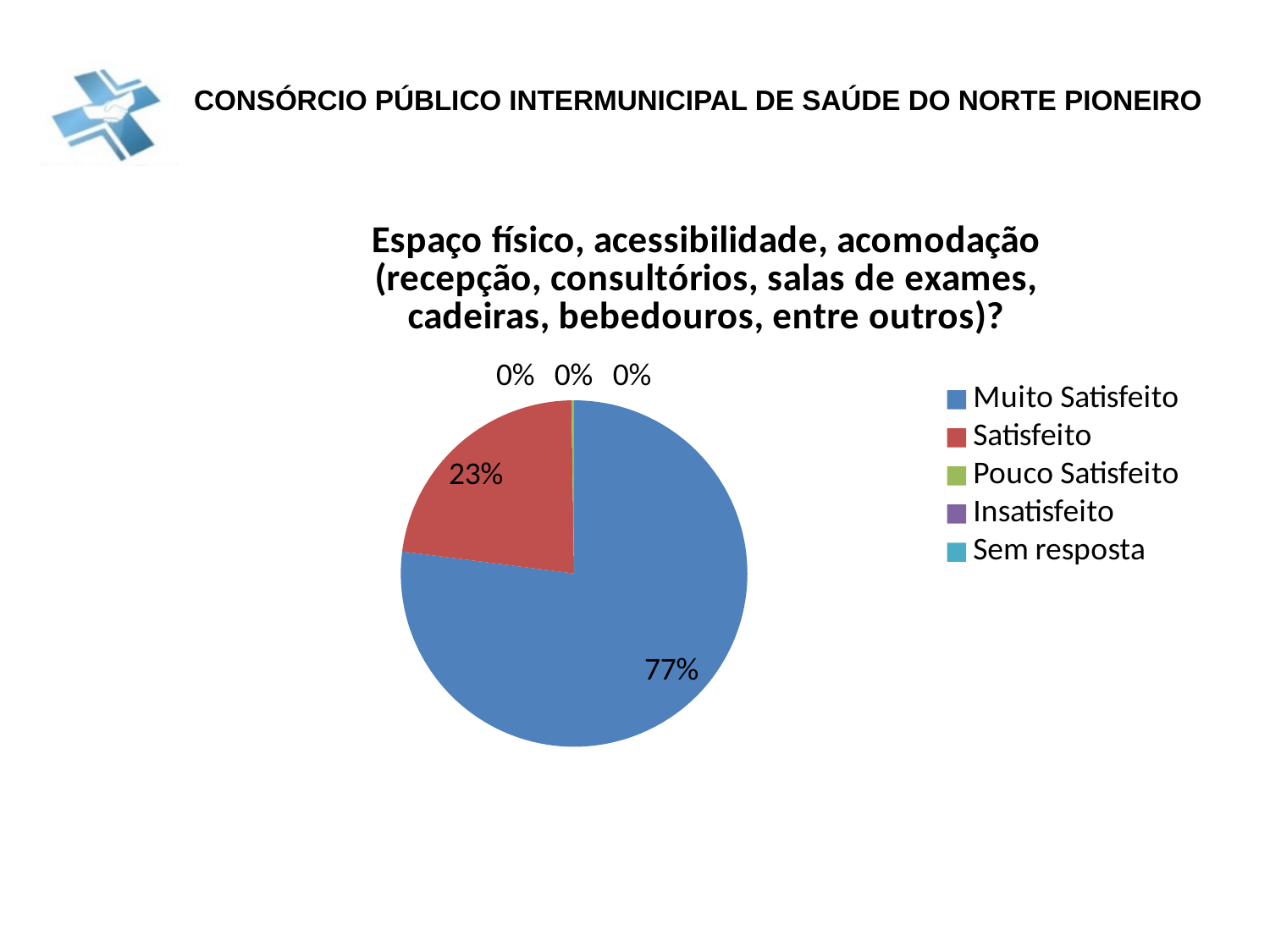
What kind of chart is shown on the slide? pie chart What share of the pie is labelled for Satisfeito? 23% What share of the pie is labelled for Muito Satisfeito? 77% Is the share for Muito Satisfeito greater or less than 50%? greater What is the difference in percentage points between the Muito Satisfeito slice and the Satisfeito slice? 54 Which legend entry is listed last? Sem resposta How many slices are labelled 0%? 3 How many categories does the legend list? 5 Which category has the largest slice of the pie? Muito Satisfeito Which is larger, the slice for Muito Satisfeito or the slice for Satisfeito? Muito Satisfeito What colour is the Satisfeito slice? red